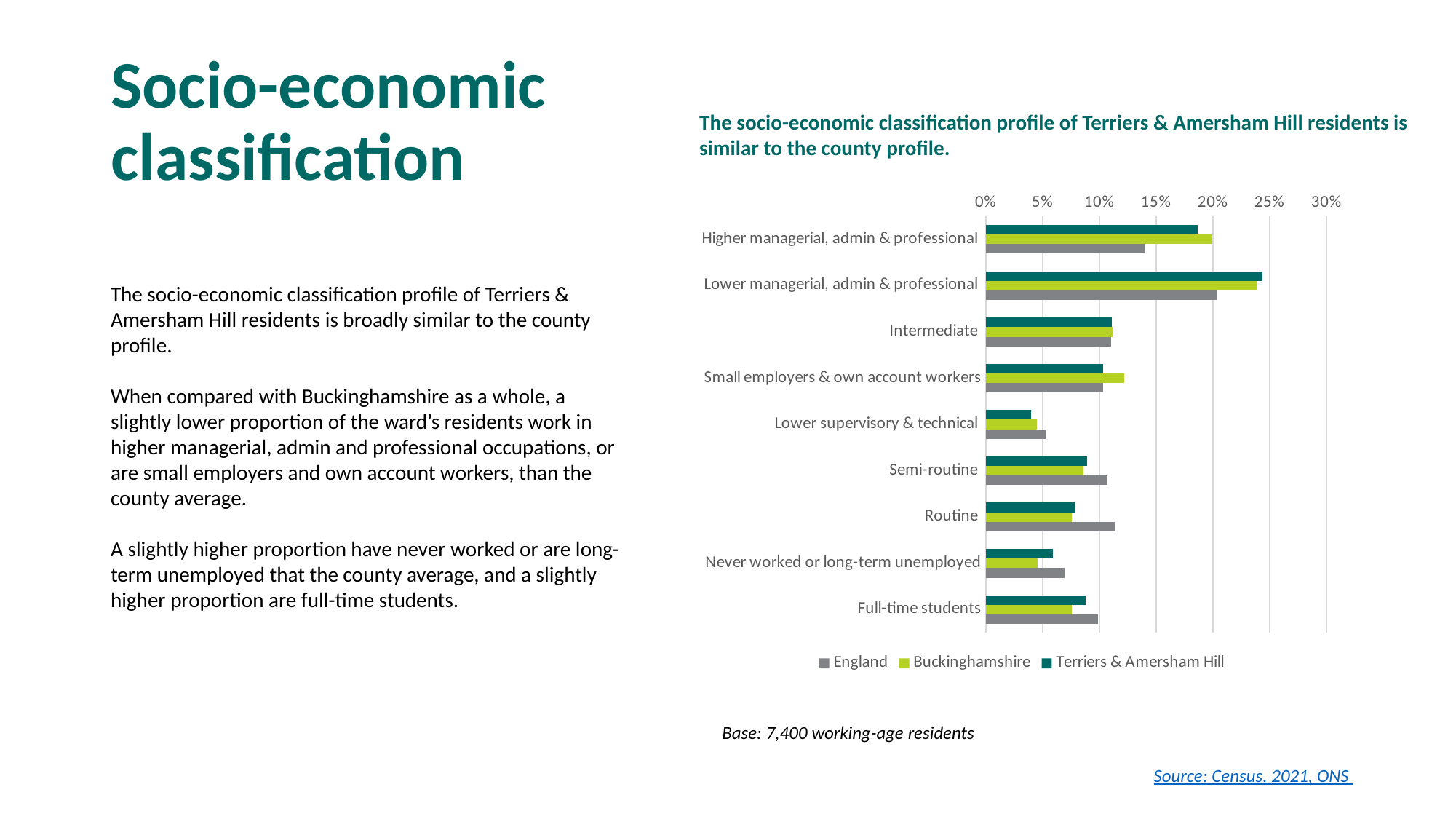
Is the value for Terriers & Amersham Hill in Higher managerial, admin & professional greater or less than 15%? greater In the Routine category, which is larger: the value for England or the value for Terriers & Amersham Hill? England Which category has the highest value for Terriers & Amersham Hill? Lower managerial, admin & professional Is the value for Buckinghamshire in Lower managerial, admin & professional greater or less than 20%? greater How many socio-economic classification categories are plotted on the chart? 9 Which colour represents England in the chart legend? Grey What kind of chart is shown on the slide? Bar chart Which category has the highest value for England? Lower managerial, admin & professional Which category has the lowest value for Terriers & Amersham Hill? Lower supervisory & technical How many series does the chart legend list? 3 Is the value for England in Higher managerial, admin & professional greater or less than 15%? less